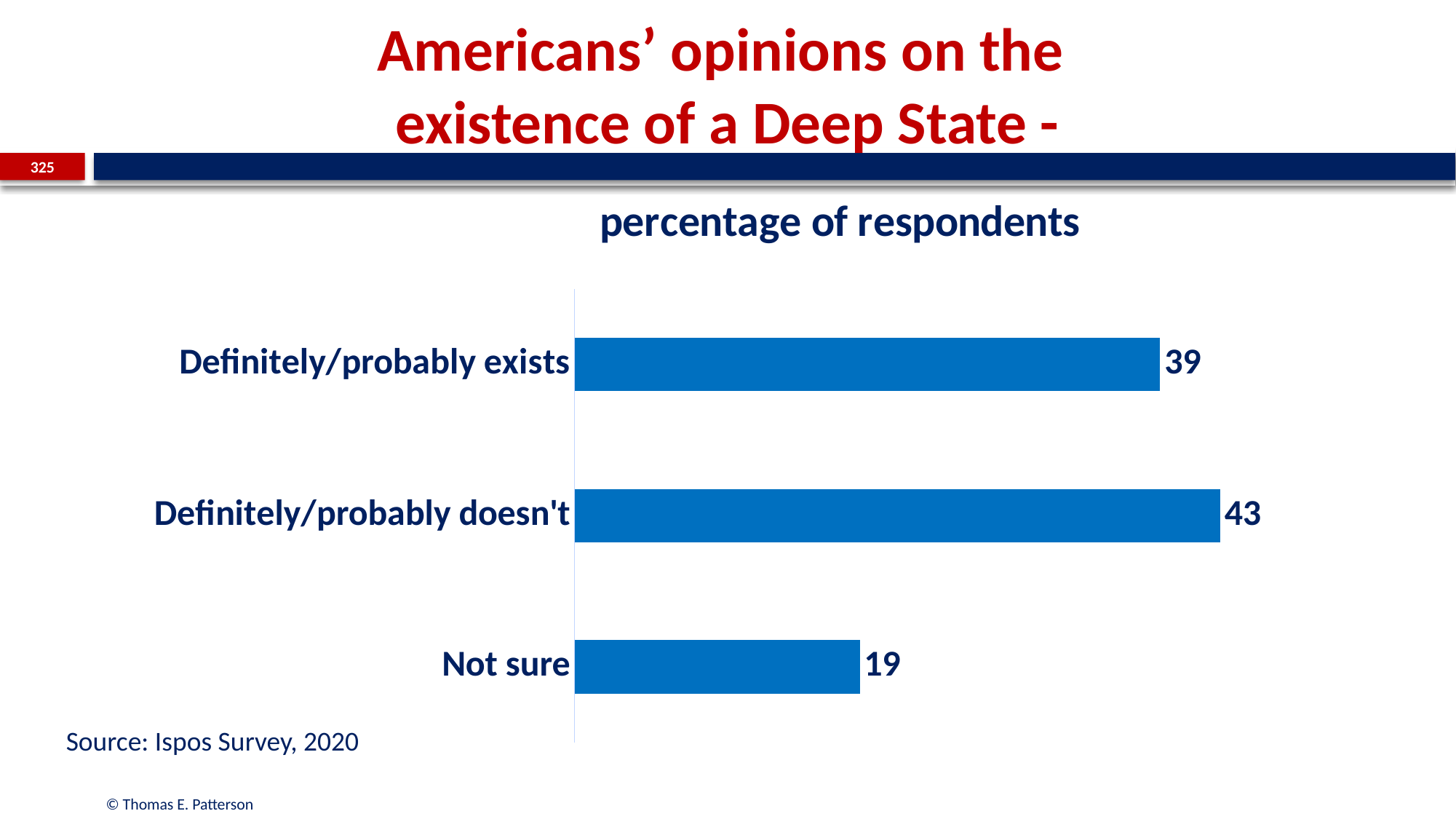
How many response categories are shown in the chart? 3 Which is larger: the percentage for 'Definitely/probably exists' or for 'Not sure'? Definitely/probably exists What is the subtitle shown above the chart? percentage of respondents What is the difference in percentage points between 'Definitely/probably doesn't' and 'Definitely/probably exists'? 4 What percentage of respondents say a Deep State definitely/probably exists? 39 What percentage of respondents say a Deep State definitely/probably doesn't exist? 43 What kind of chart is shown on the slide? Bar chart What is the difference in percentage points between 'Definitely/probably exists' and 'Not sure'? 20 Which response category has the lowest percentage of respondents? Not sure What source is cited for the chart data? Ispos Survey, 2020 What percentage of respondents are not sure about the existence of a Deep State? 19 Which response category has the highest percentage of respondents? Definitely/probably doesn't